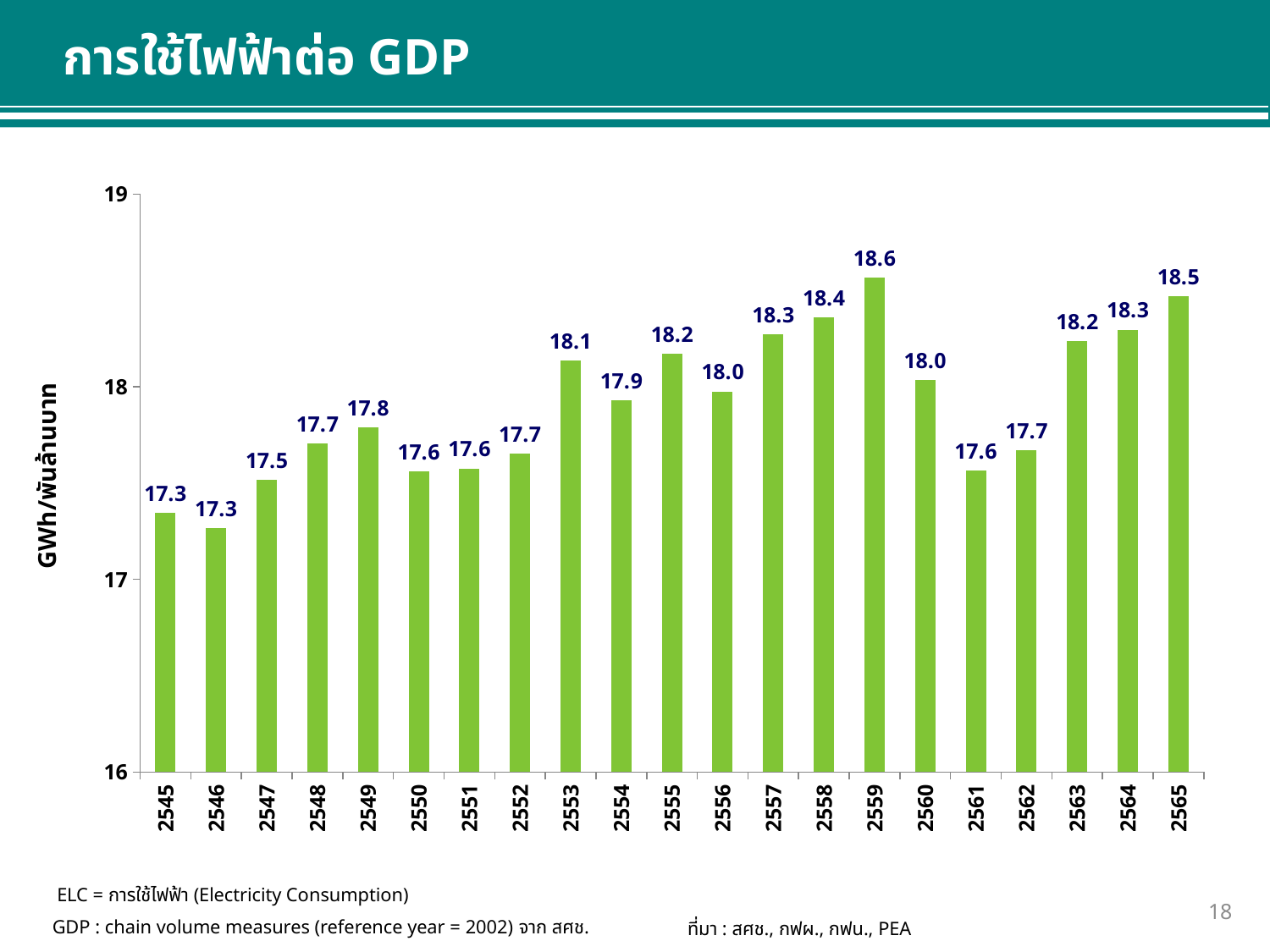
Is the value for 2561 greater or less than 18? less What is the value for 2559? 18.6 What is the difference between the values for 2559 and 2545? 1.3 What is the value for 2565? 18.5 What kind of chart is shown on the slide? bar chart Which is larger, the value for 2558 or the value for 2560? 2558 What is the value for 2545? 17.3 What is the value for 2554? 17.9 Which year has the highest value? 2559 How many years are shown on the x axis? 21 What is the difference between the values for 2565 and 2561? 0.9 What is the label of the y axis? GWh/พันล้านบาท